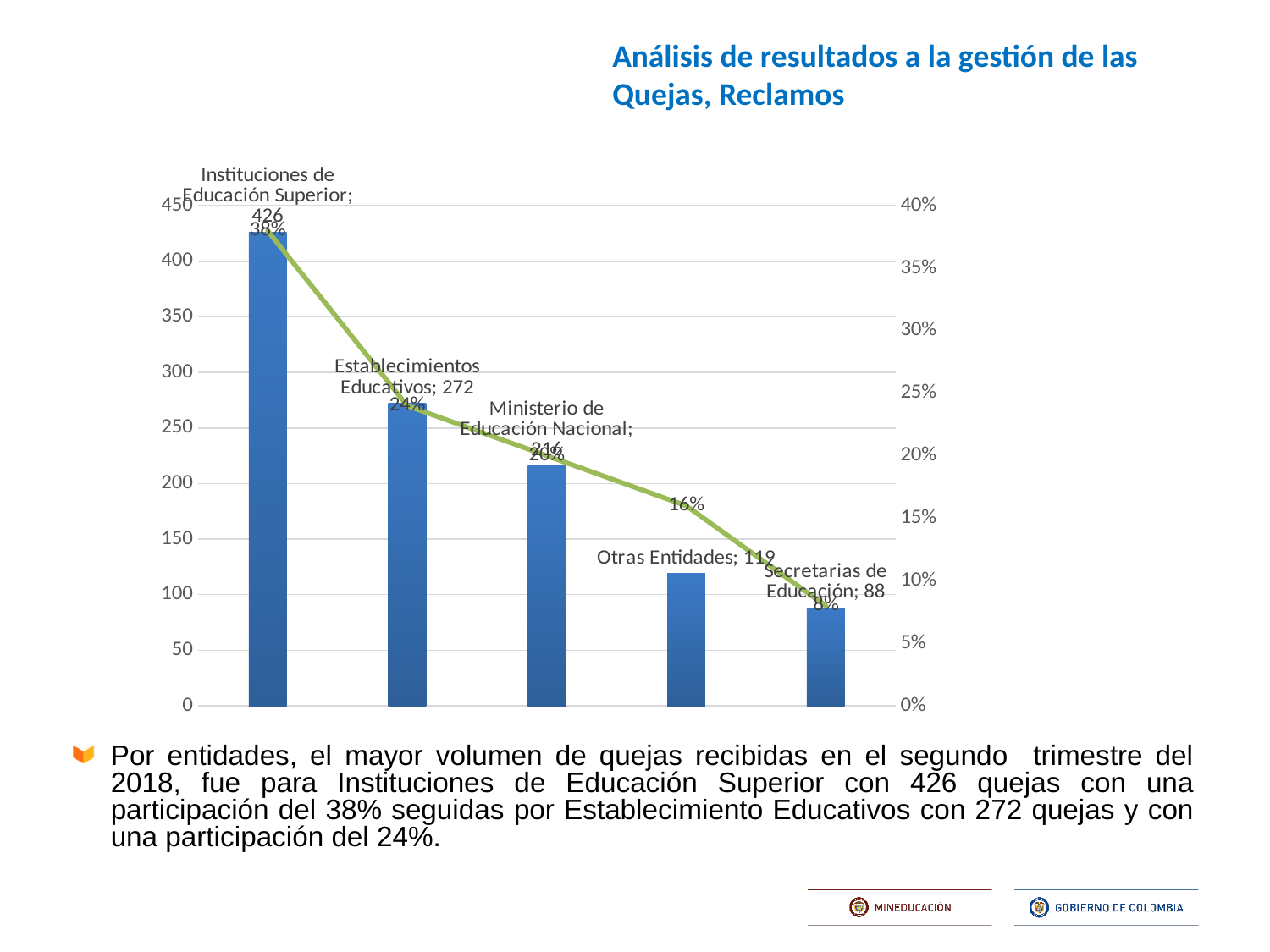
What percentage share is shown on the line for Establecimientos Educativos? 24% What percentage share is shown on the line for Instituciones de Educación Superior? 38% Is the bar for Ministerio de Educación Nacional greater or less than 250? less What is the value shown for Secretarias de Educación? 88 What is the value shown for Otras Entidades? 119 What is the difference between the values for Instituciones de Educación Superior and Establecimientos Educativos? 154 What is the number of complaints for Instituciones de Educación Superior? 426 What is the value shown for Establecimientos Educativos? 272 Which is larger, the value for Otras Entidades or the value for Secretarias de Educación? Otras Entidades How many categories are plotted as bars in the chart? 5 Which category has the lowest bar? Secretarias de Educación Which category has the highest bar? Instituciones de Educación Superior